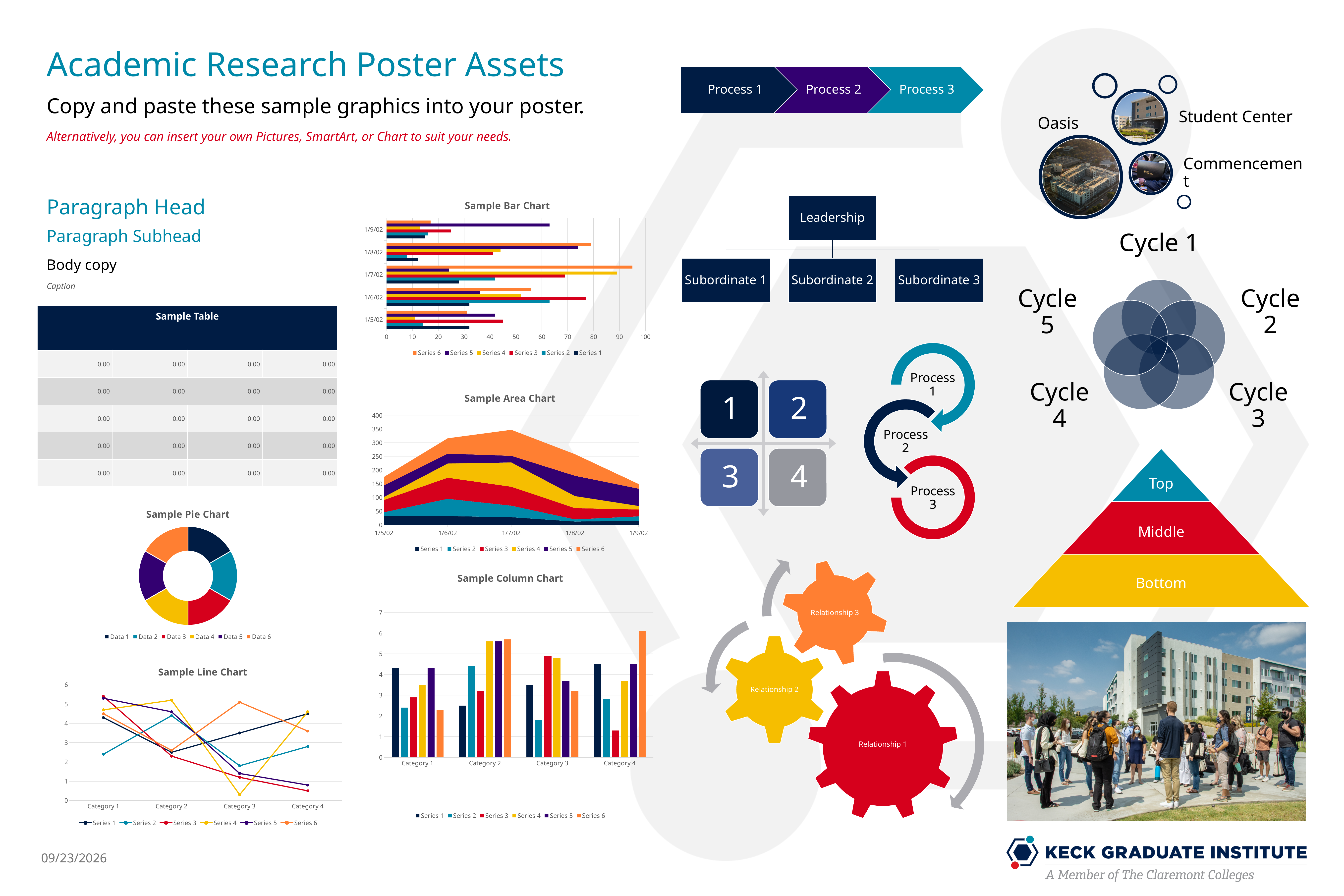
In the Sample Line Chart, does Series 3 rise or fall from Category 1 to Category 4? fall In the Sample Bar Chart, is the value for Series 6 at 1/7/02 greater or less than 80? greater What kind of chart is the Sample Area Chart? area chart How many series does the legend of the Sample Area Chart list? 6 In the Sample Column Chart, is the value for Series 2 at Category 3 greater or less than 2? less In the Sample Column Chart, is the value for Series 6 at Category 4 greater or less than 5? greater How many series does the legend of the Sample Bar Chart list? 6 What kind of chart is the Sample Bar Chart? bar chart How many slices does the Sample Pie Chart have? 6 How many categories are shown on the x axis of the Sample Column Chart? 4 How many date categories are shown on the Sample Bar Chart? 5